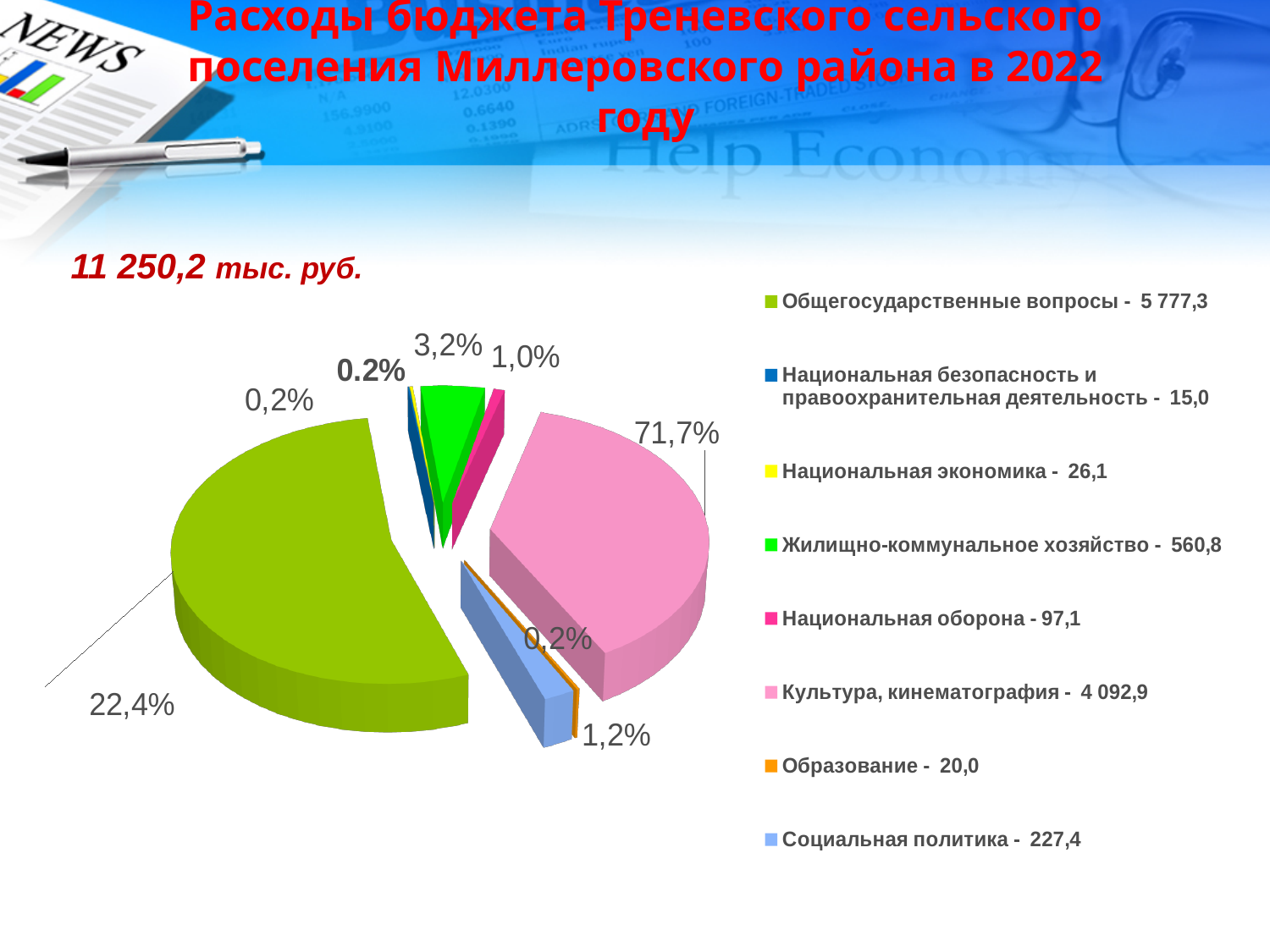
What value is given in the legend for Жилищно-коммунальное хозяйство? 560,8 Which is larger according to the legend: Образование or Национальная экономика? Национальная экономика Which is larger according to the legend: Социальная политика or Жилищно-коммунальное хозяйство? Жилищно-коммунальное хозяйство Which category has the largest value in the legend? Общегосударственные вопросы Which category has the smallest value in the legend? Национальная безопасность и правоохранительная деятельность What kind of chart is shown on the slide? pie chart What value is given in the legend for Национальная оборона? 97,1 What value is given in the legend for Культура, кинематография? 4 092,9 How many categories does the legend of the pie chart list? 8 What value is given in the legend for Социальная политика? 227,4 What total amount is printed above the pie chart? 11 250,2 тыс. руб. By how much does the legend value for Общегосударственные вопросы exceed that for Культура, кинематография? 1 684,4